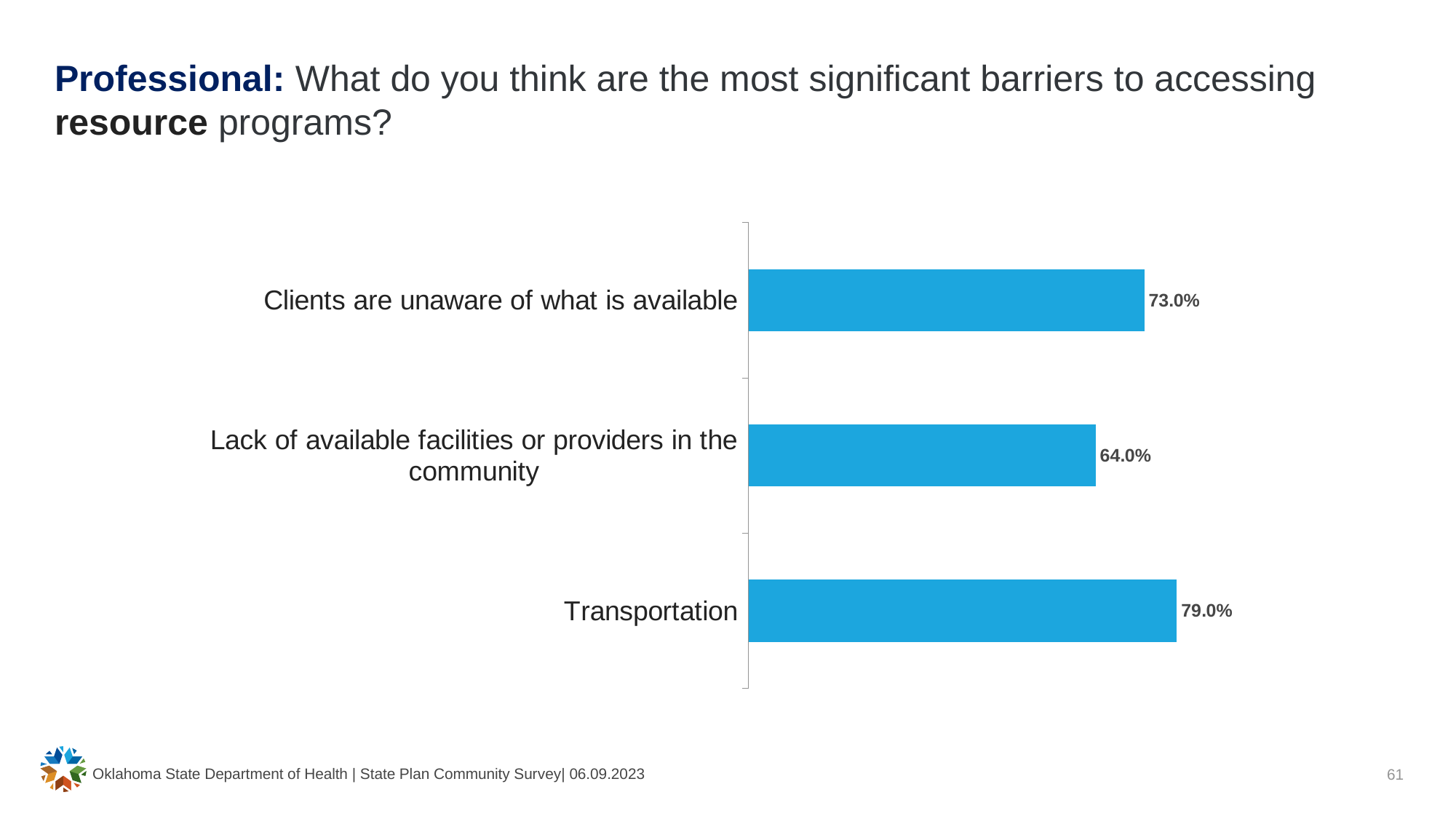
What colour are the bars in the chart? Blue What is the difference between the values for Transportation and Clients are unaware of what is available? 6.0% Which category has the highest value? Transportation How many categories are shown in the chart? 3 Which category is listed at the bottom of the chart? Transportation What is the value for Lack of available facilities or providers in the community? 64.0% What is the difference between the values for Clients are unaware of what is available and Lack of available facilities or providers in the community? 9.0% What is the value for Transportation? 79.0% Which category has the lowest value? Lack of available facilities or providers in the community What kind of chart is shown on the slide? Bar chart What is the value for Clients are unaware of what is available? 73.0% Which is larger, the value for Transportation or the value for Lack of available facilities or providers in the community? Transportation